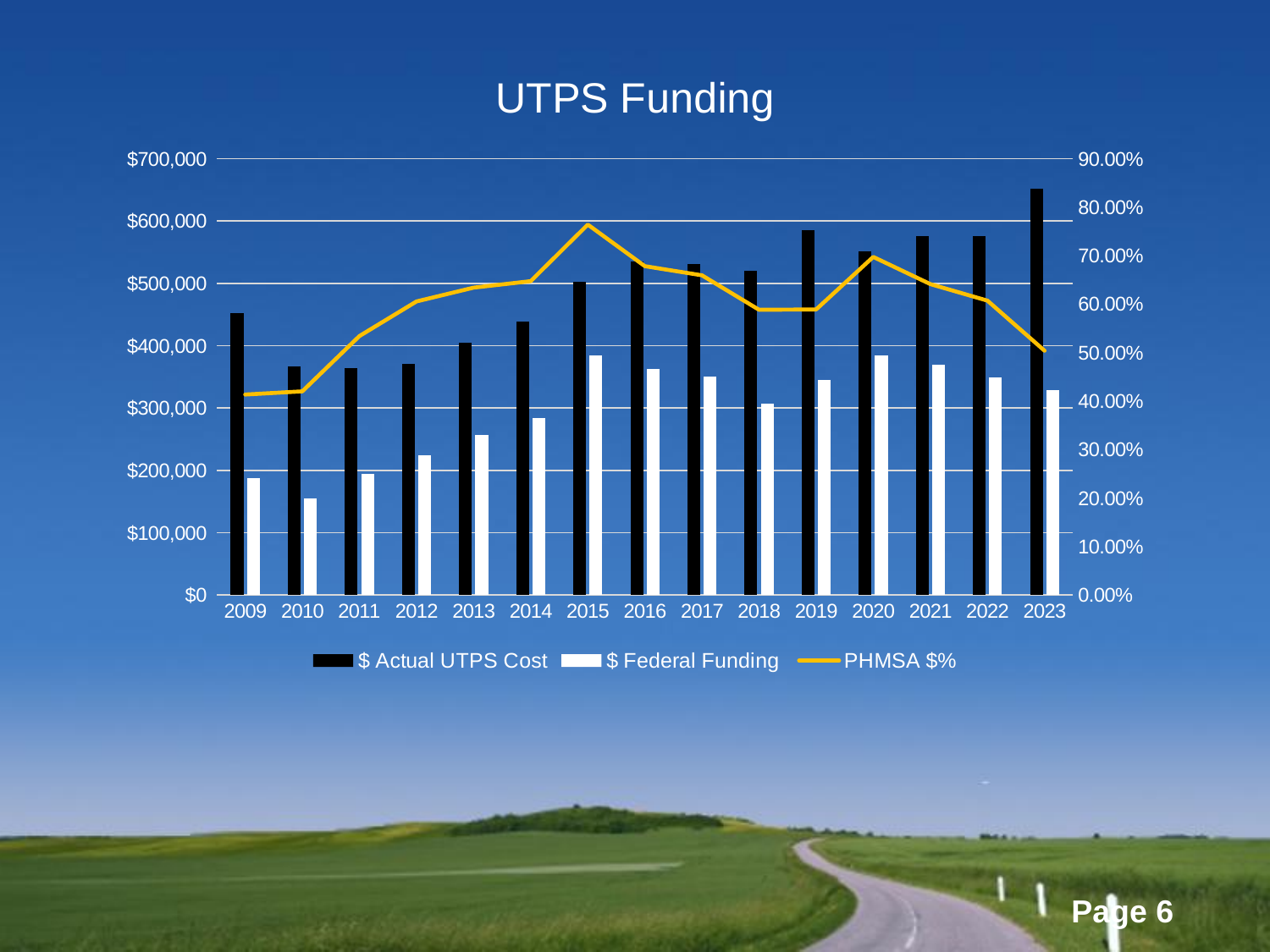
How many years are shown on the x axis? 15 Which year has the highest $ Actual UTPS Cost? 2023 Does the PHMSA $% line rise or fall from 2020 to 2023? fall What kind of chart is shown on the slide? A combination bar and line chart In which year does the PHMSA $% line reach its highest point? 2015 Which year has the larger $ Actual UTPS Cost, 2010 or 2019? 2019 Is the $ Actual UTPS Cost for 2023 greater or less than $600,000? greater What is the title of the chart? UTPS Funding Which year has the lowest $ Federal Funding? 2010 How many series does the legend list? 3 Is the $ Federal Funding for 2010 greater or less than $200,000? less Is the PHMSA $% value for 2015 greater or less than 70.00%? greater